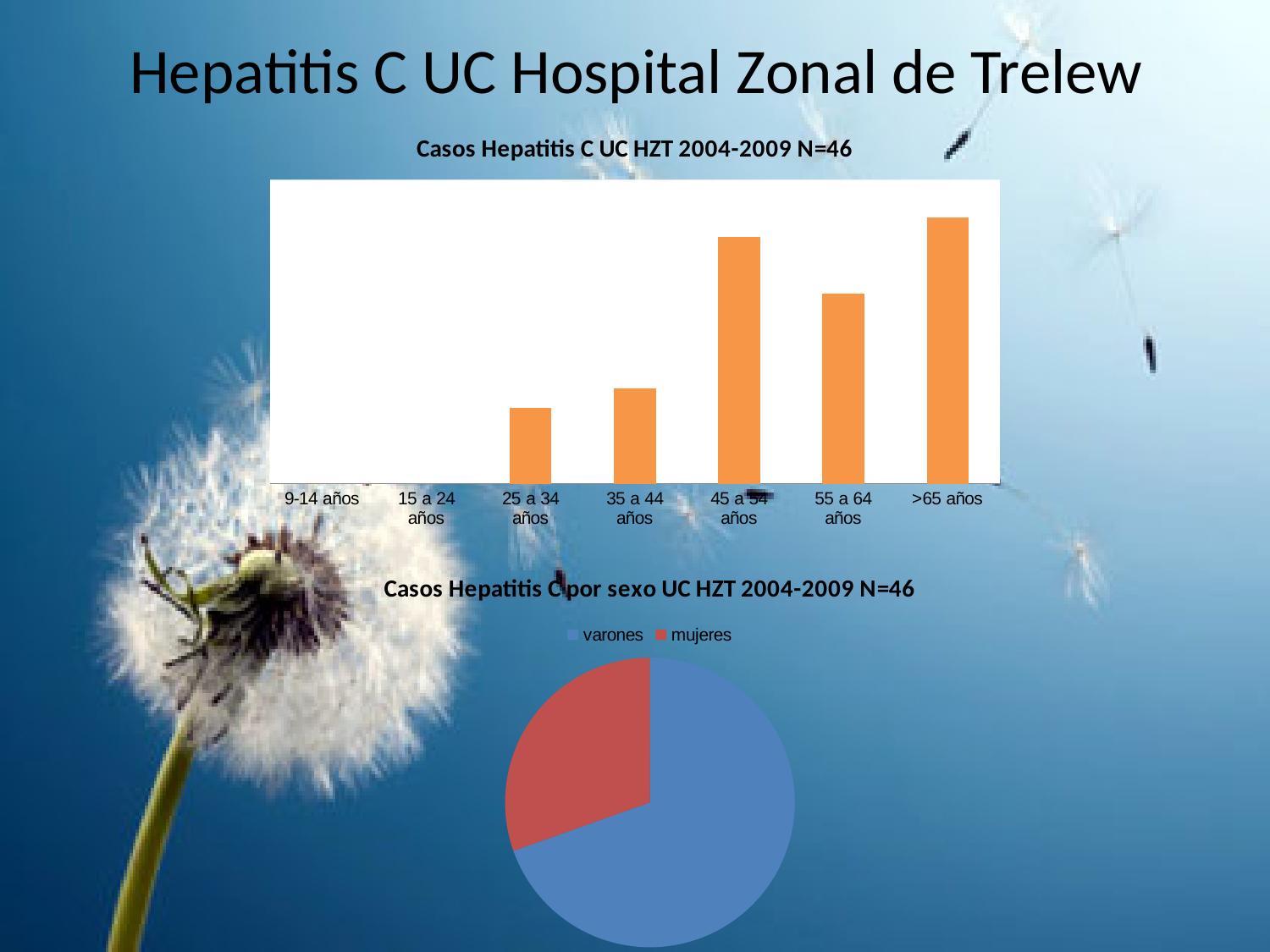
In the bottom pie chart, what colour is the slice for mujeres? red What kind of chart is the top chart titled 'Casos Hepatitis C UC HZT 2004-2009 N=46'? bar chart In the top bar chart, do the values generally rise or fall from the youngest to the oldest age group? rise What kind of chart is the bottom chart titled 'Casos Hepatitis C por sexo UC HZT 2004-2009 N=46'? pie chart In the top bar chart, which is larger, the value for 25 a 34 años or for 35 a 44 años? 35 a 44 años In the bottom pie chart, how many entries does the legend list? 2 In the top bar chart, which is larger, the value for 35 a 44 años or for >65 años? >65 años In the bottom pie chart, which group has the larger slice, varones or mujeres? varones What is the title of the top chart? Casos Hepatitis C UC HZT 2004-2009 N=46 In the top bar chart, which age category has the highest value? >65 años In the top bar chart, how many age categories are shown on the x axis? 7